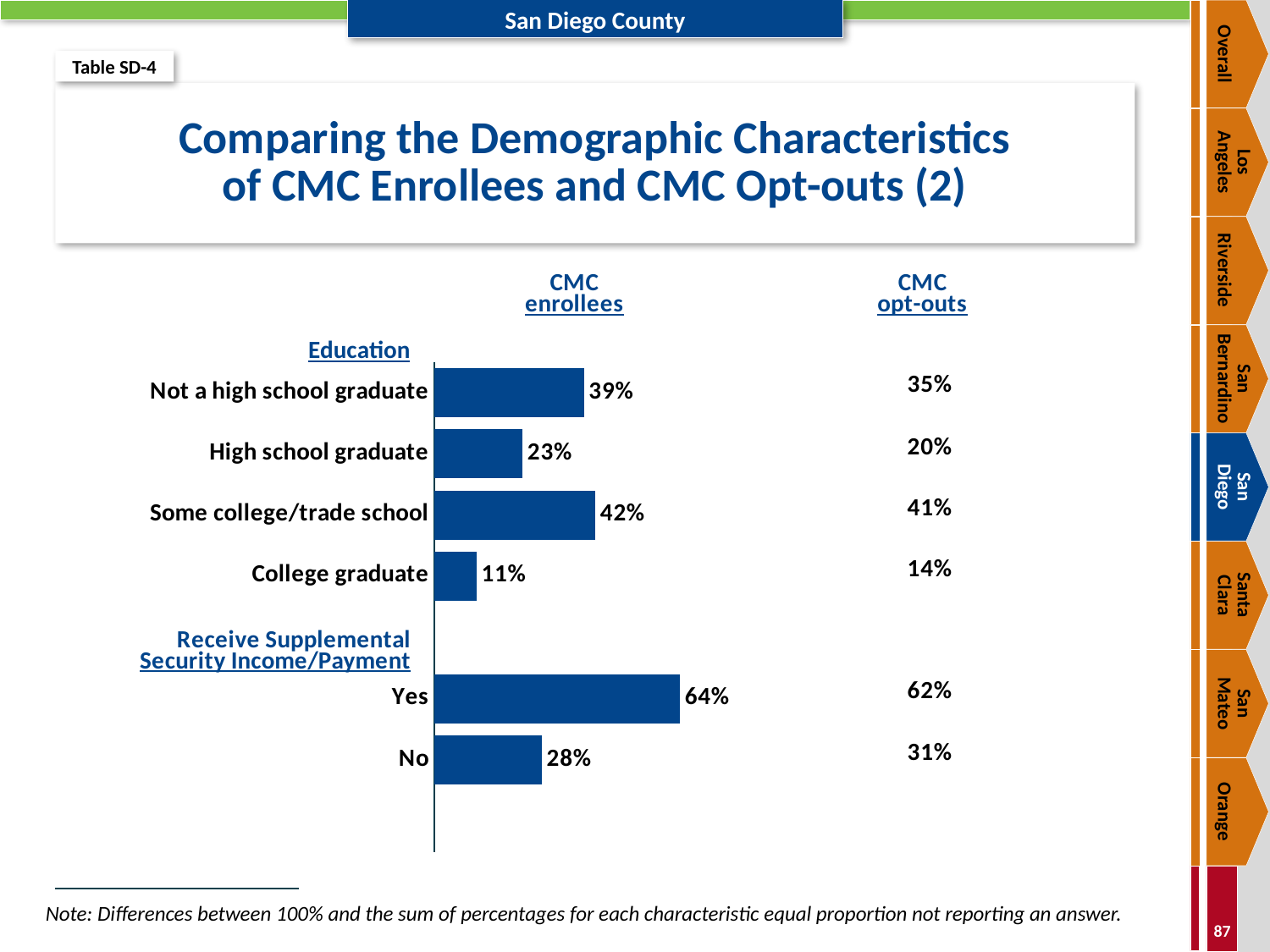
Among the Education categories, which has the lowest percentage of CMC enrollees? College graduate Among the Education categories, which has the highest percentage of CMC enrollees? Some college/trade school What is the title of the chart on this slide? Comparing the Demographic Characteristics of CMC Enrollees and CMC Opt-outs (2) What type of chart is used to show the CMC enrollees percentages? Bar chart What percentage of CMC opt-outs are college graduates? 14% What percentage of CMC enrollees receive Supplemental Security Income/Payment (Yes)? 64% How many bars are plotted in the CMC enrollees bar chart? 6 What percentage of CMC enrollees are college graduates? 11% What is the difference between the CMC enrollees percentages for 'Some college/trade school' and 'High school graduate'? 19% For CMC enrollees, which is larger: the percentage for 'Yes' or 'No' under Receive Supplemental Security Income/Payment? Yes What percentage of CMC enrollees are not a high school graduate? 39% What is the difference between the CMC enrollees and CMC opt-outs percentages for 'Not a high school graduate'? 4%